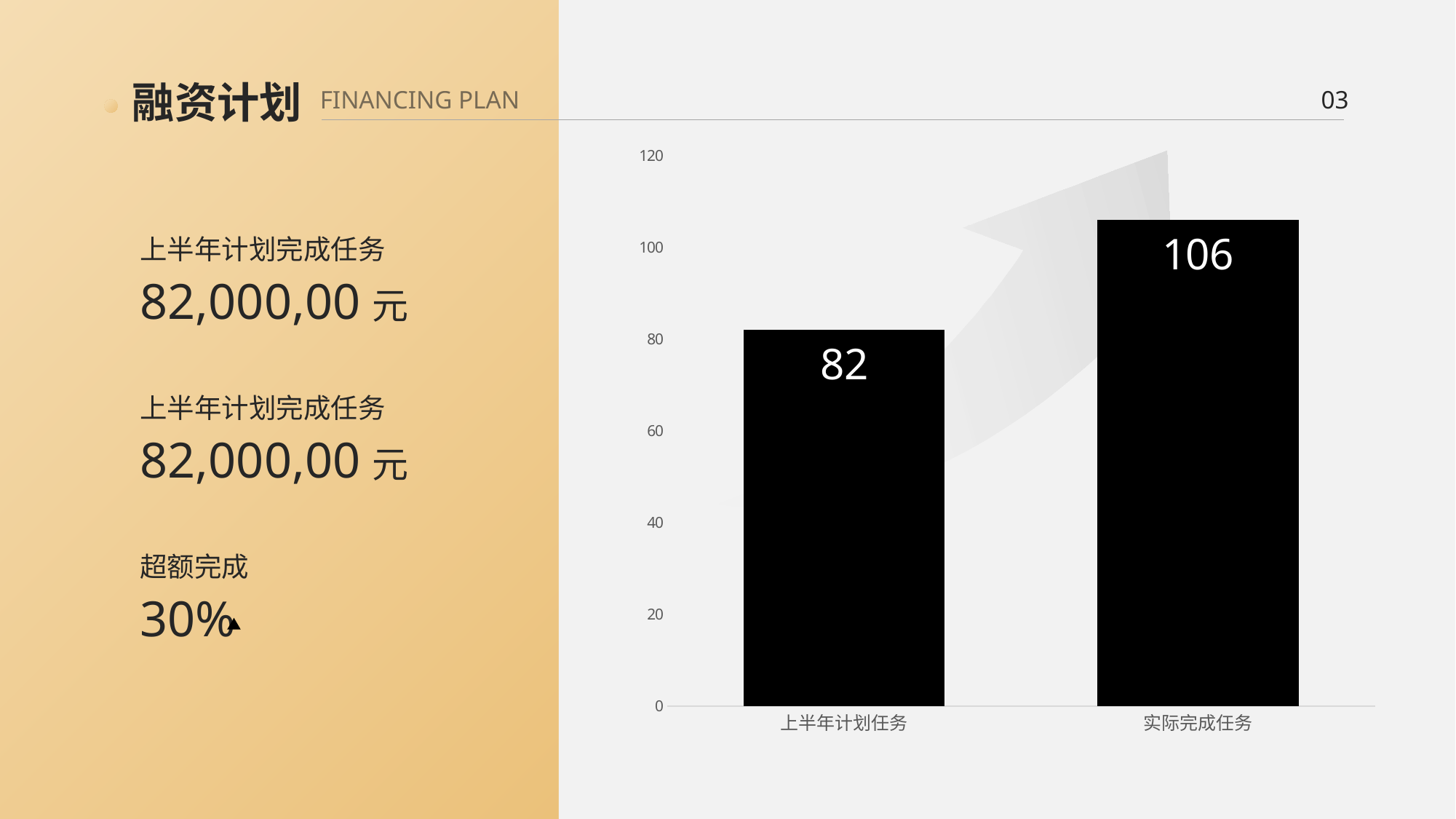
Which category has the highest value? 实际完成任务 Do the values rise or fall from 上半年计划任务 to 实际完成任务? rise Is the value for 上半年计划任务 greater or less than 100? less How many categories are shown on the x axis of the chart? 2 What is the maximum value shown on the chart's vertical axis? 120 What is the difference between the values for 实际完成任务 and 上半年计划任务? 24 What kind of chart is shown on the slide? bar chart What is the value for 实际完成任务? 106 Which category has the lowest value? 上半年计划任务 What is the value for 上半年计划任务? 82 Is the value for 实际完成任务 greater or less than 100? greater Which is larger, the value for 上半年计划任务 or the value for 实际完成任务? 实际完成任务